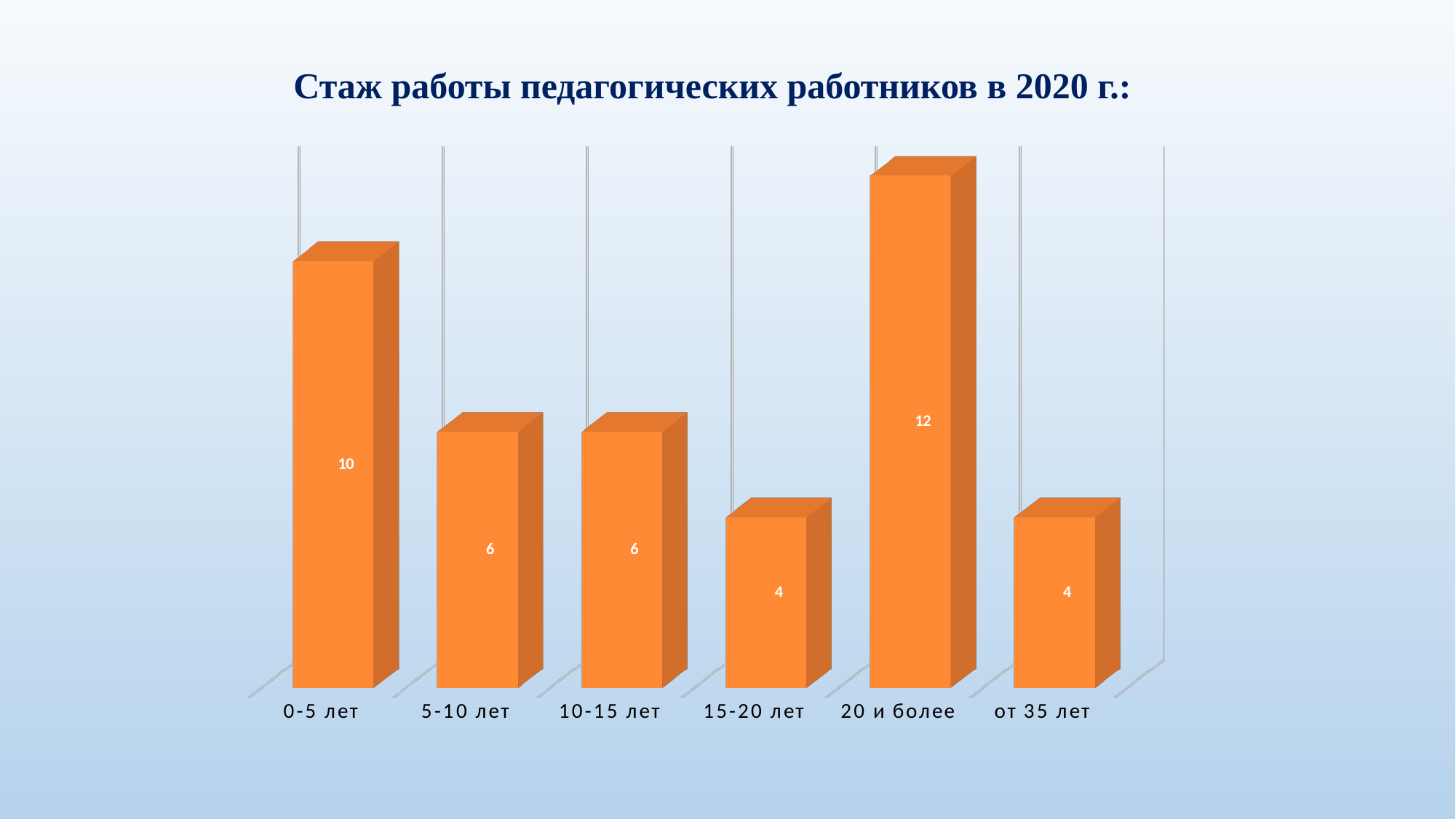
What is the value for the 20 и более category? 12 Which category has the highest value? 20 и более What is the title of the chart? Стаж работы педагогических работников в 2020 г.: How many categories are shown on the chart? 6 What kind of chart is shown on the slide? Bar chart What is the difference between the values for 20 и более and 0-5 лет? 2 What is the value for the 0-5 лет category? 10 What is the difference between the values for 0-5 лет and 15-20 лет? 6 What is the value for the 15-20 лет category? 4 What is the value for the 5-10 лет category? 6 Which is larger, the value for 10-15 лет or the value for от 35 лет? 10-15 лет Which is larger, the value for 0-5 лет or the value for 5-10 лет? 0-5 лет